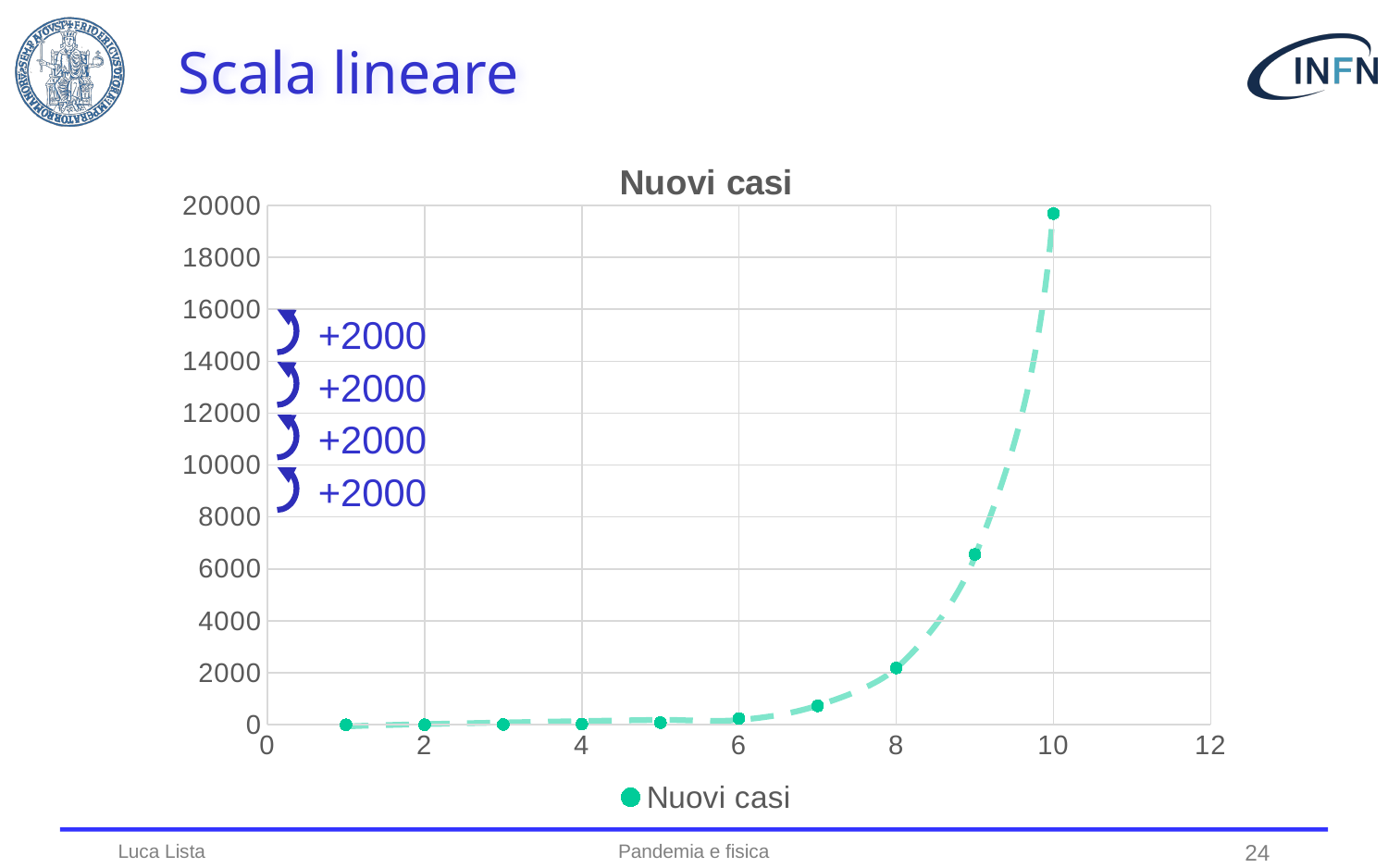
At which x value is the plotted value highest? 10 Is the value at x = 9 greater or less than 8000? less Is the value at x = 8 greater or less than 4000? less How many data points are plotted in the chart? 10 What is the title of the chart? Nuovi casi What label is shown in the legend below the chart? Nuovi casi What kind of chart is shown on the slide? line chart Which has the larger value, x = 9 or x = 10? 10 How many series does the legend list? 1 Is the value at x = 7 greater or less than 2000? less Do the values rise or fall as x increases along the x axis? rise